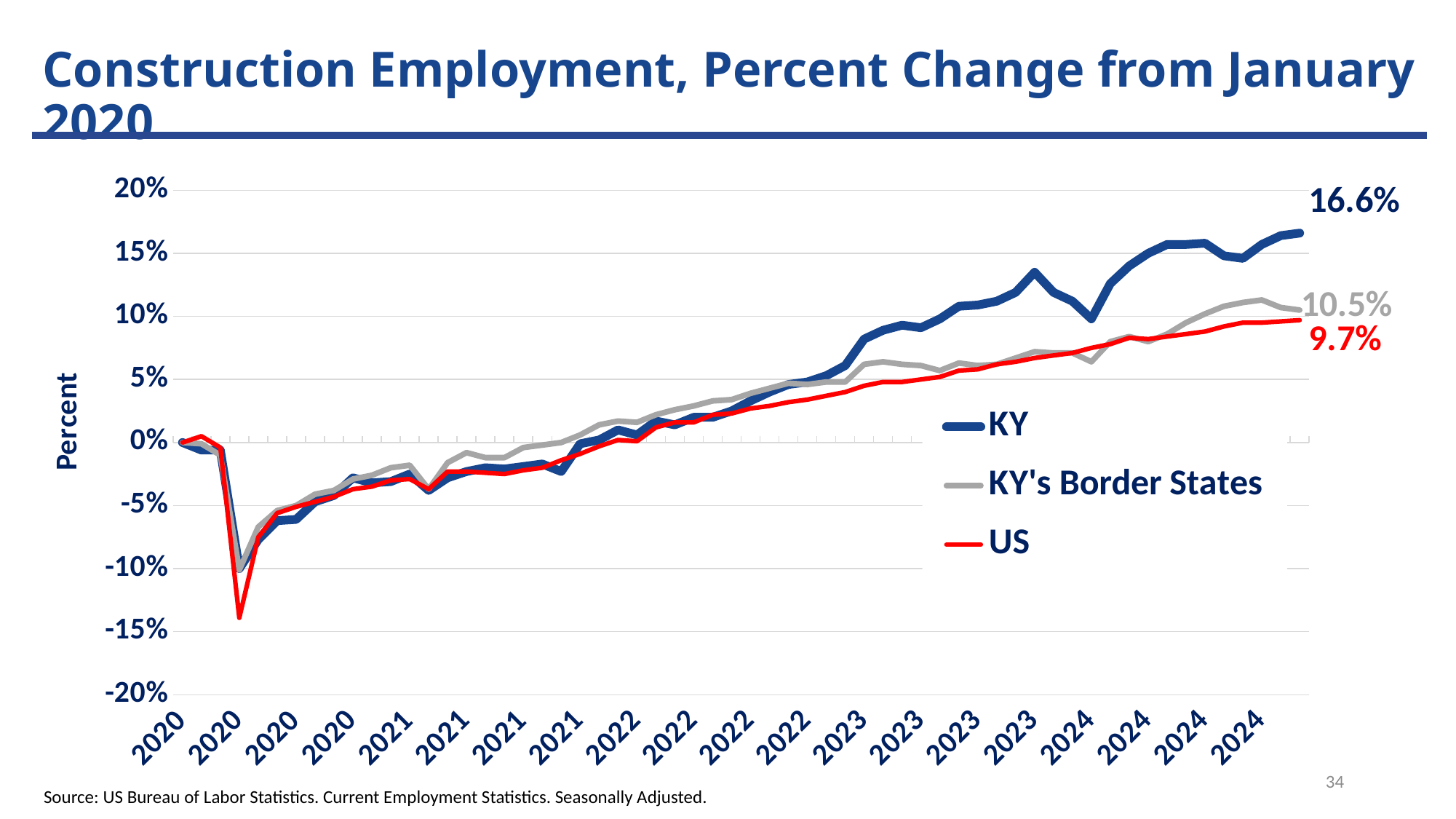
At the end of the chart, which is larger: the KY value or the KY's Border States value? KY What is the final labeled value for the KY series? 16.6% What is the final labeled value for the KY's Border States series? 10.5% What type of chart is shown on the slide? line chart What is the difference between the final KY value and the final US value? 6.9 percentage points Which series has the lowest value at the end of the chart? US Do the values for the KY series generally rise or fall from 2021 to 2024? rise What is the label on the vertical axis? Percent Which series has the highest value at the end of the chart? KY Is the lowest point of the US series in 2020 greater or less than -10%? less What is the final labeled value for the US series? 9.7% How many series does the legend list? 3